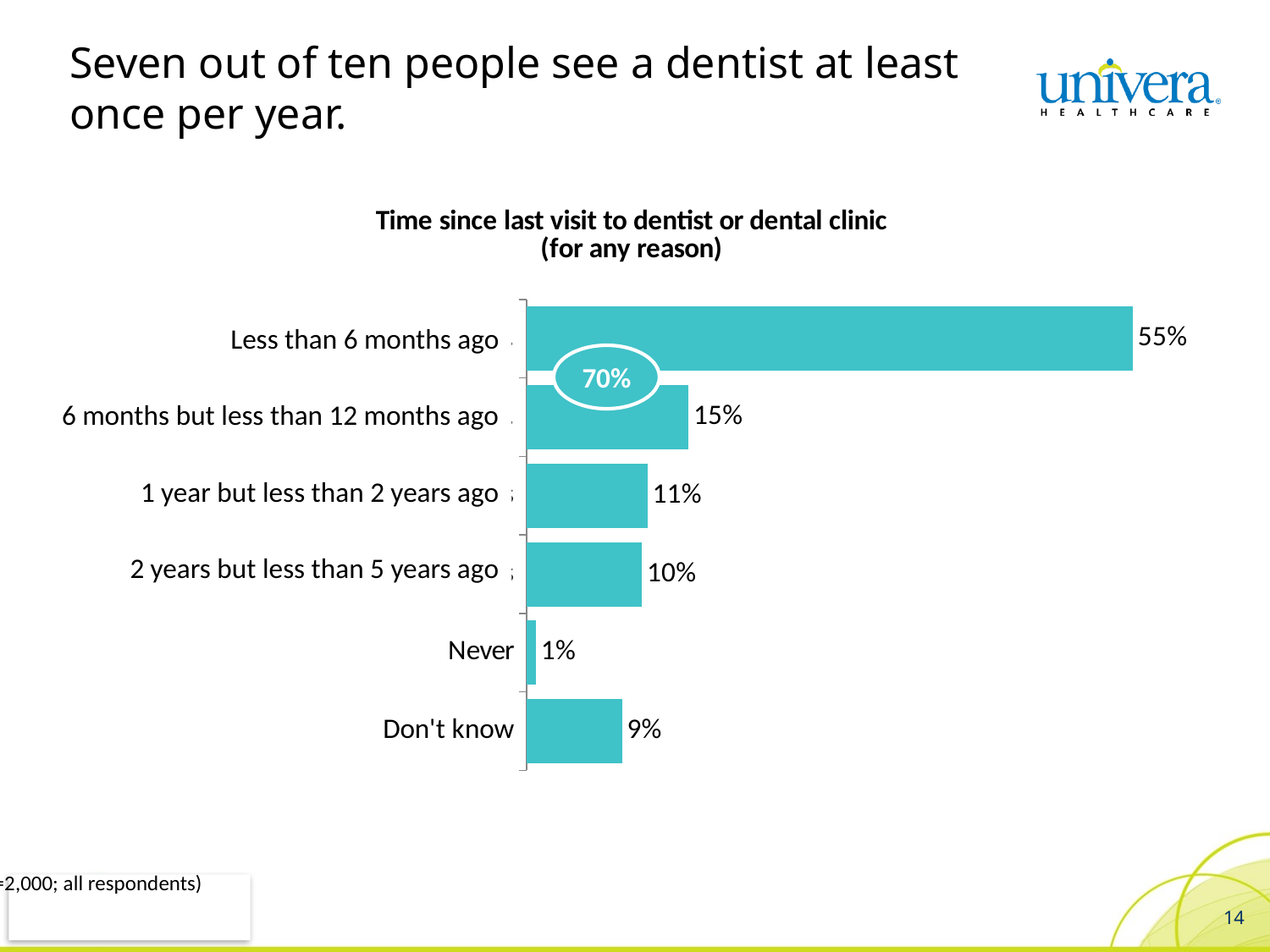
What is the value for '1 year but less than 2 years ago'? 11% What is the value for '6 months but less than 12 months ago'? 15% What kind of chart is shown on the slide? Bar chart Which category has the highest value? Less than 6 months ago Which is larger: '2 years but less than 5 years ago' or 'Don't know'? 2 years but less than 5 years ago Which category has the lowest value? Never How many categories are shown in the chart? 6 What percentage of respondents answered 'Don't know'? 9% What is the title of the chart? Time since last visit to dentist or dental clinic (for any reason) What percentage of respondents last visited a dentist less than 6 months ago? 55% What is the difference between 'Less than 6 months ago' and '6 months but less than 12 months ago'? 40% What percentage of respondents answered 'Never'? 1%